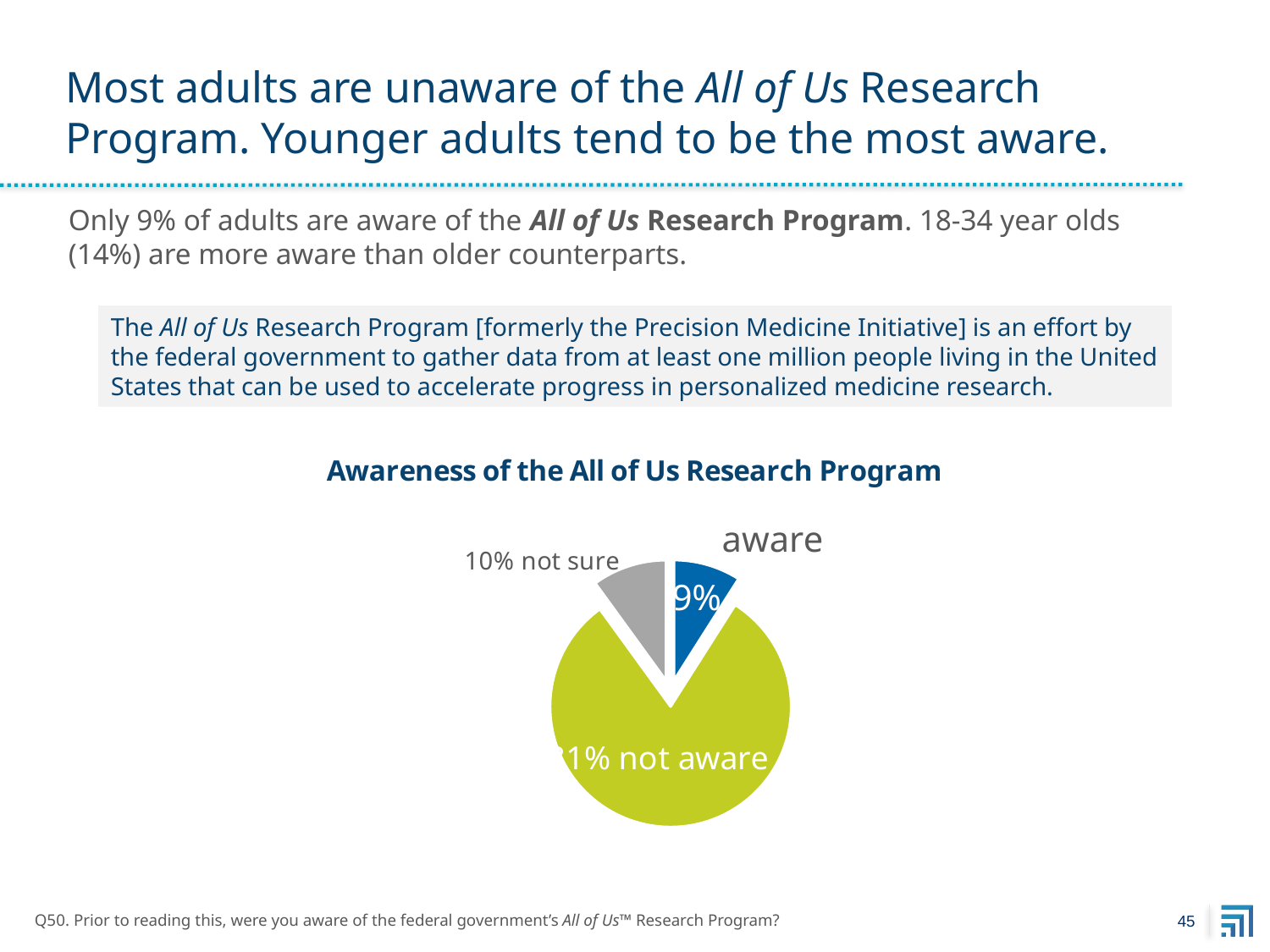
Which slice of the pie chart is the largest? not aware What percentage of adults are aware of the All of Us Research Program according to the pie chart? 9% What is the title of the chart? Awareness of the All of Us Research Program How many slices does the pie chart have? 3 What kind of chart is shown on the slide? pie chart What is the difference in percentage points between the 'not sure' slice and the 'aware' slice? 1 What percentage of adults are not sure according to the pie chart? 10% Which slice of the pie chart is the smallest? aware What colour is the 'not aware' slice of the pie chart? green What share of the pie does the 'aware' slice represent? 9% Which is larger in the pie chart, the 'aware' slice or the 'not sure' slice? not sure